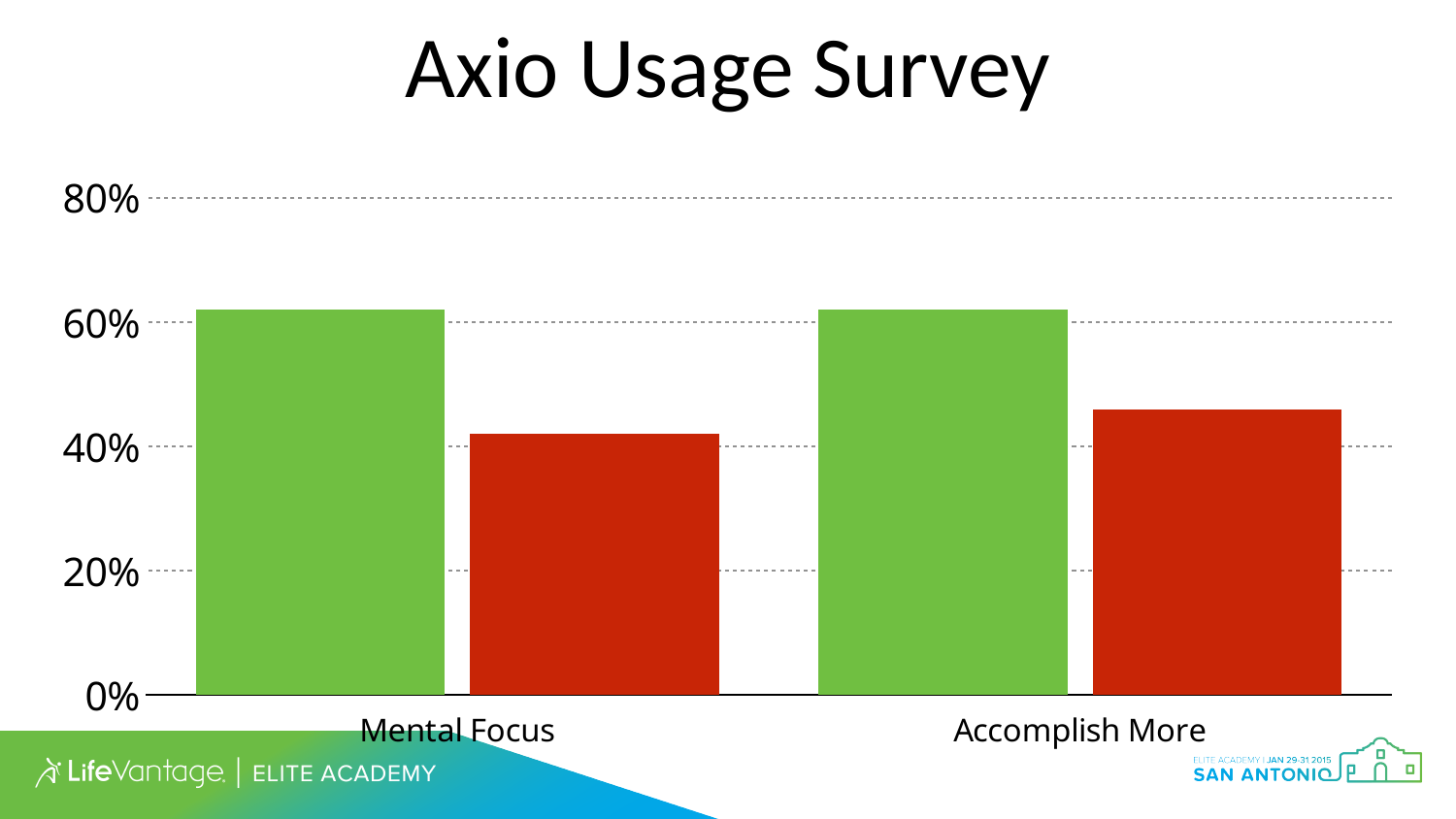
How many categories are shown on the x axis? 2 Is the green bar for Accomplish More greater or less than 80%? less What kind of chart is shown on the slide? bar chart Is the green bar for Mental Focus greater or less than 60%? greater How many bars are plotted in the chart? 4 Which category has the taller red bar, Mental Focus or Accomplish More? Accomplish More Is the red bar for Mental Focus greater or less than 60%? less What is the title of the chart? Axio Usage Survey What is the highest value shown on the y axis? 80% For Mental Focus, which bar is taller, the green one or the red one? the green one